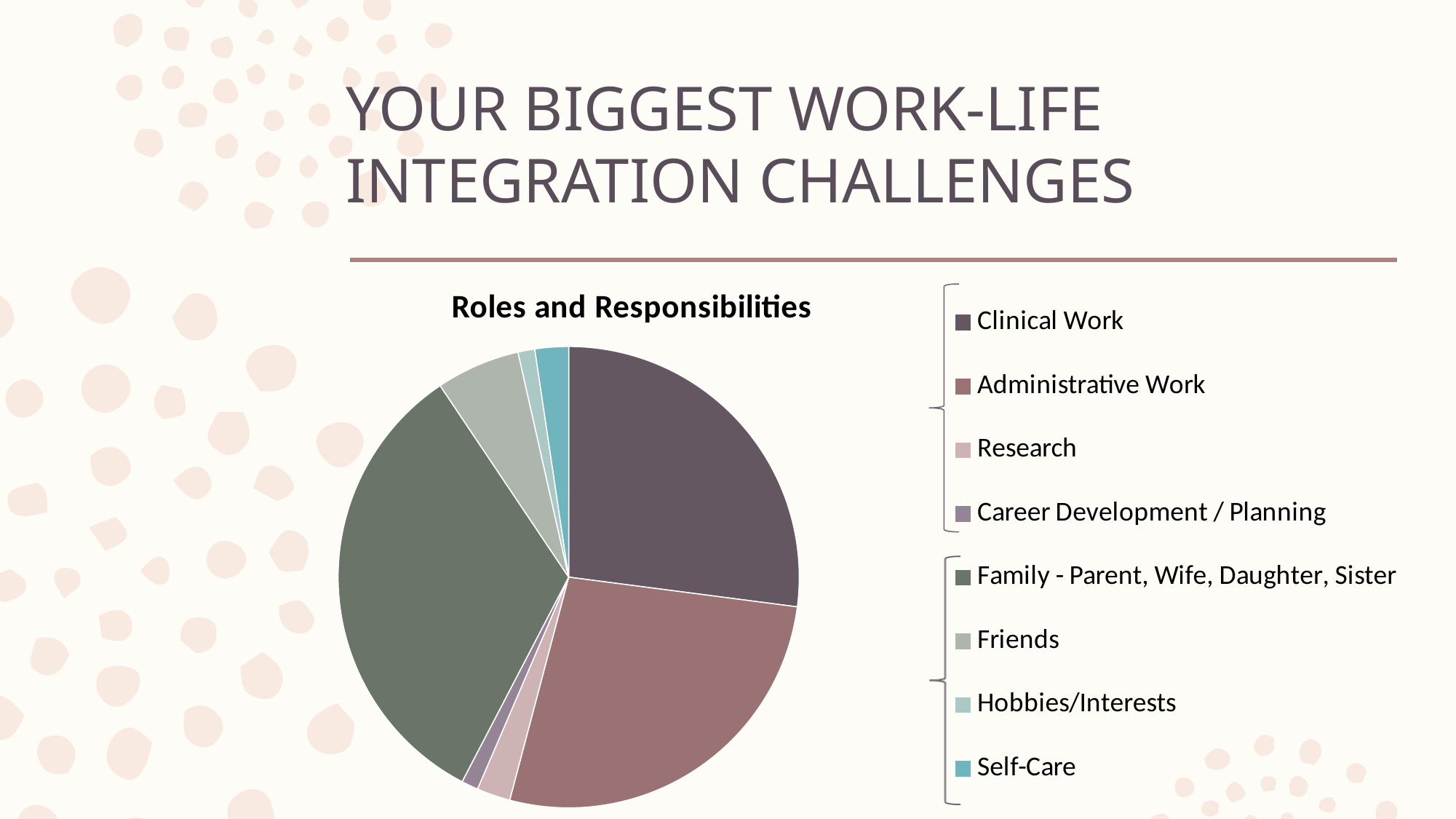
How many entries does the legend list? 8 Which slice is larger, Clinical Work or Friends? Clinical Work How many categories does the pie chart have? 8 Which slice is larger, Research or Clinical Work? Clinical Work Which legend entry is shown in teal? Self-Care What is the title of the chart? Roles and Responsibilities Which slice is larger, Family - Parent, Wife, Daughter, Sister or Administrative Work? Family - Parent, Wife, Daughter, Sister What kind of chart is shown on the slide? pie chart Which category has the largest slice of the pie? Family - Parent, Wife, Daughter, Sister